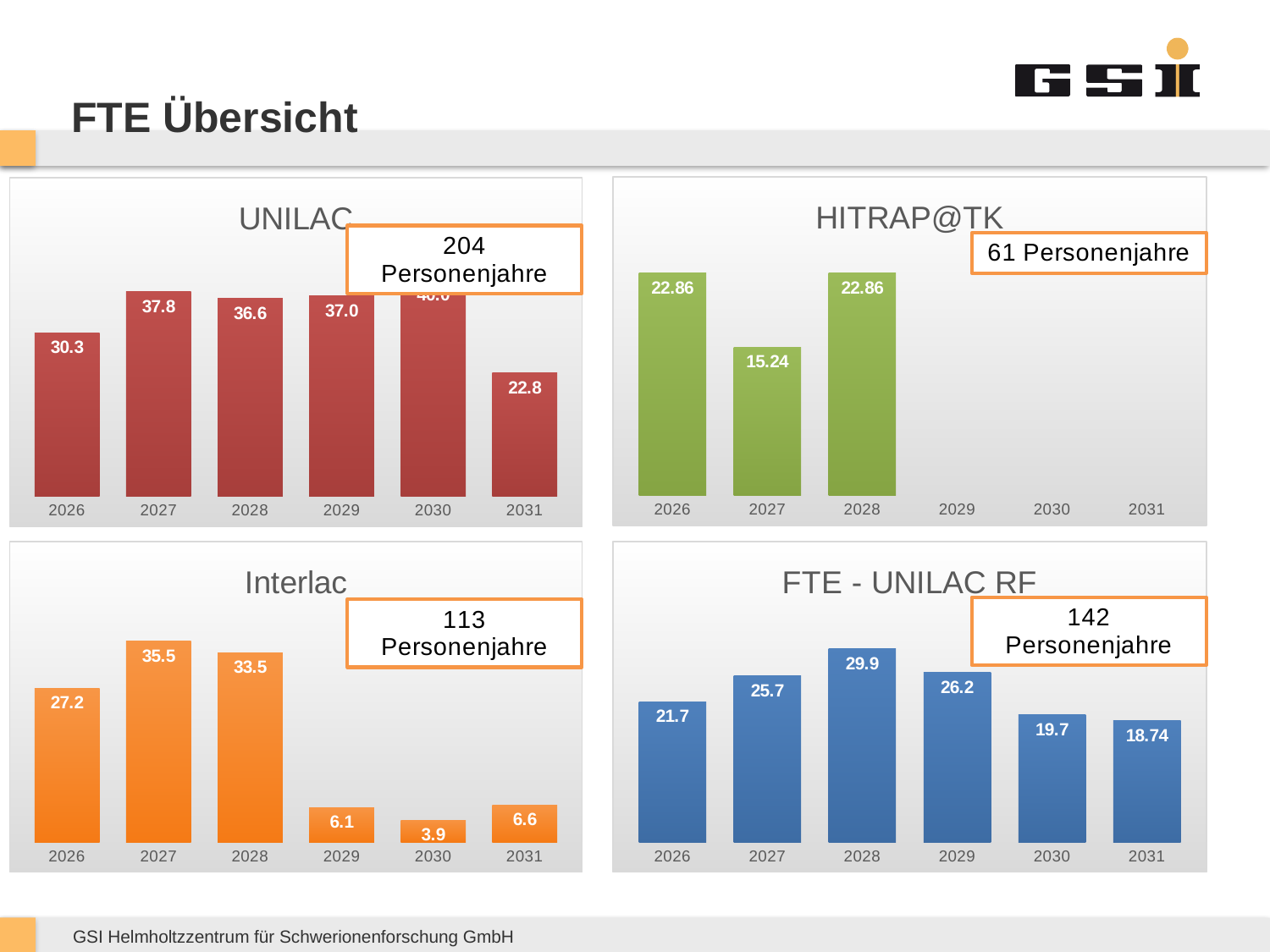
In the HITRAP@TK chart, which year has the lowest value among the years with a bar? 2027 What kind of chart is the FTE - UNILAC RF chart? bar chart In the FTE - UNILAC RF chart, what is the value for 2031? 18.74 In the Interlac chart, what is the value for 2030? 3.9 In the Interlac chart, which year has the highest value? 2027 In the UNILAC chart, what is the value for 2026? 30.3 In the HITRAP@TK chart, how many years have a bar plotted? 3 In the FTE - UNILAC RF chart, which year has the highest value? 2028 In the UNILAC chart, what is the difference between the values for 2027 and 2028? 1.2 In the Interlac chart, is the value for 2028 larger than the value for 2029? Yes In the UNILAC chart, which year has the lowest value? 2031 In the HITRAP@TK chart, what is the value for 2027? 15.24